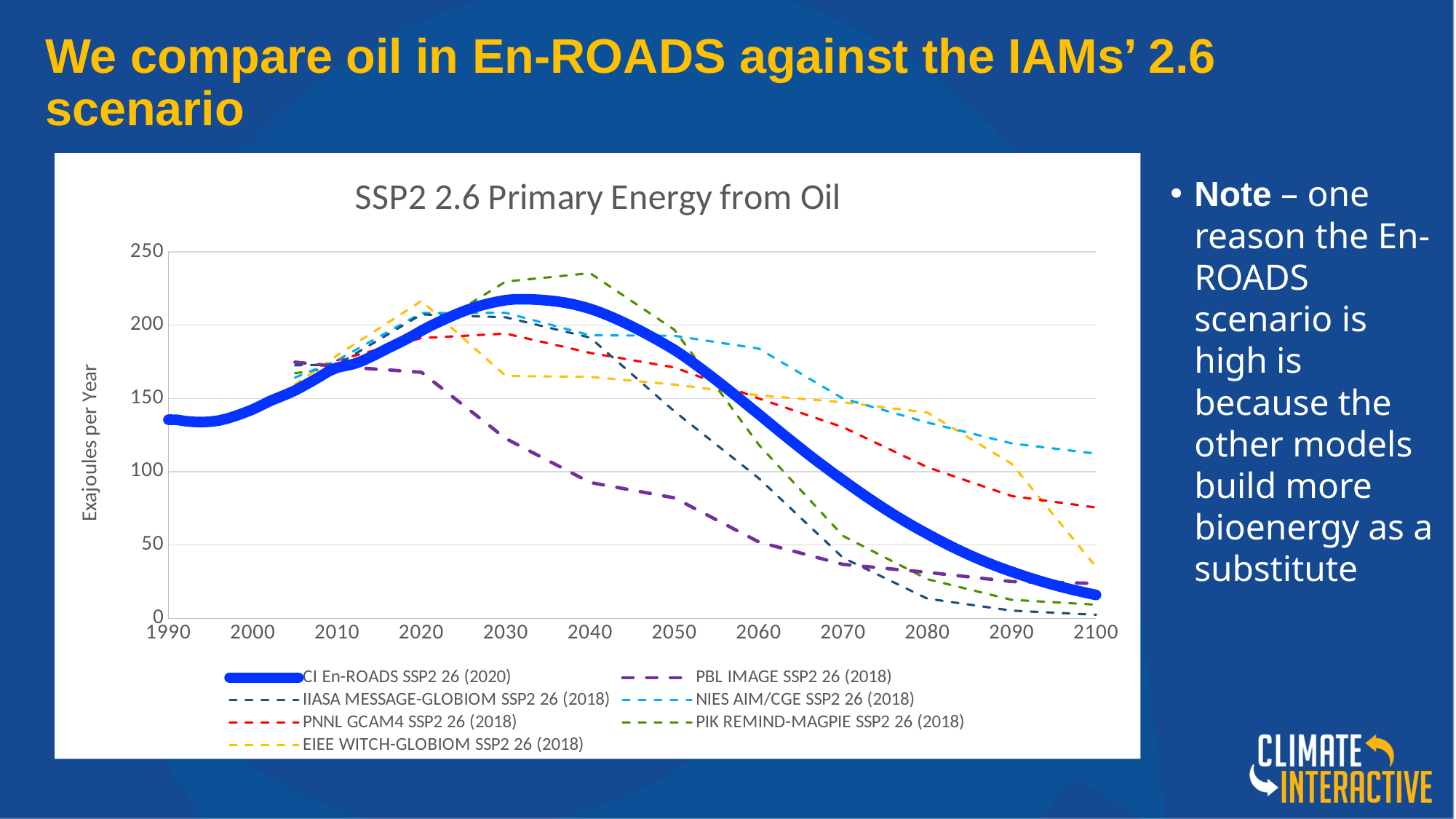
What is the title of the chart? SSP2 2.6 Primary Energy from Oil Which series has the highest value in 2100? NIES AIM/CGE SSP2 26 (2018) Is the value for NIES AIM/CGE SSP2 26 (2018) in 2100 greater or less than 100? greater In 2040, which is larger: PIK REMIND-MAGPIE SSP2 26 (2018) or PBL IMAGE SSP2 26 (2018)? PIK REMIND-MAGPIE SSP2 26 (2018) What kind of chart is shown on the slide? Line chart How many series does the legend list? 7 What is the label on the vertical axis? Exajoules per Year Is the value for CI En-ROADS SSP2 26 (2020) in 1990 greater or less than 150? less Is the value for PIK REMIND-MAGPIE SSP2 26 (2018) in 2040 greater or less than 200? greater Does the CI En-ROADS SSP2 26 (2020) line rise or fall between 2040 and 2100? Fall